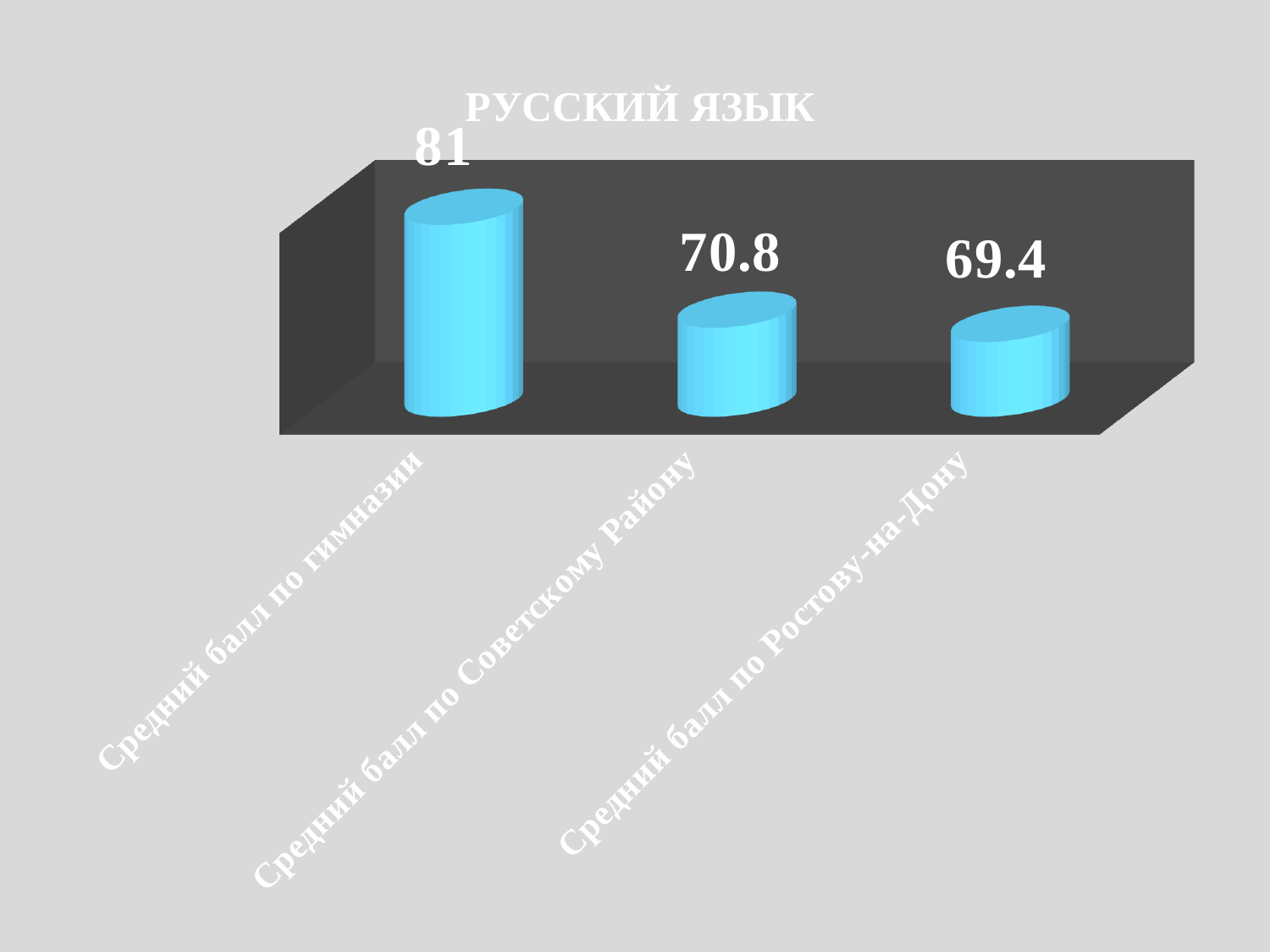
Which category has the lowest value? Средний балл по Ростову-на-Дону Which is larger: the value for Средний балл по гимназии or the value for Средний балл по Ростову-на-Дону? Средний балл по гимназии Which category has the highest value? Средний балл по гимназии What is the difference between the value for Средний балл по Советскому Району and the value for Средний балл по Ростову-на-Дону? 1.4 What is the difference between the value for Средний балл по гимназии and the value for Средний балл по Советскому Району? 10.2 What is the title of the chart? РУССКИЙ ЯЗЫК Do the values rise or fall from left to right across the categories? fall What is the value for Средний балл по Ростову-на-Дону? 69.4 How many categories are shown in the chart? 3 What kind of chart is shown on the slide? bar chart What is the value for Средний балл по Советскому Району? 70.8 What is the value for Средний балл по гимназии? 81